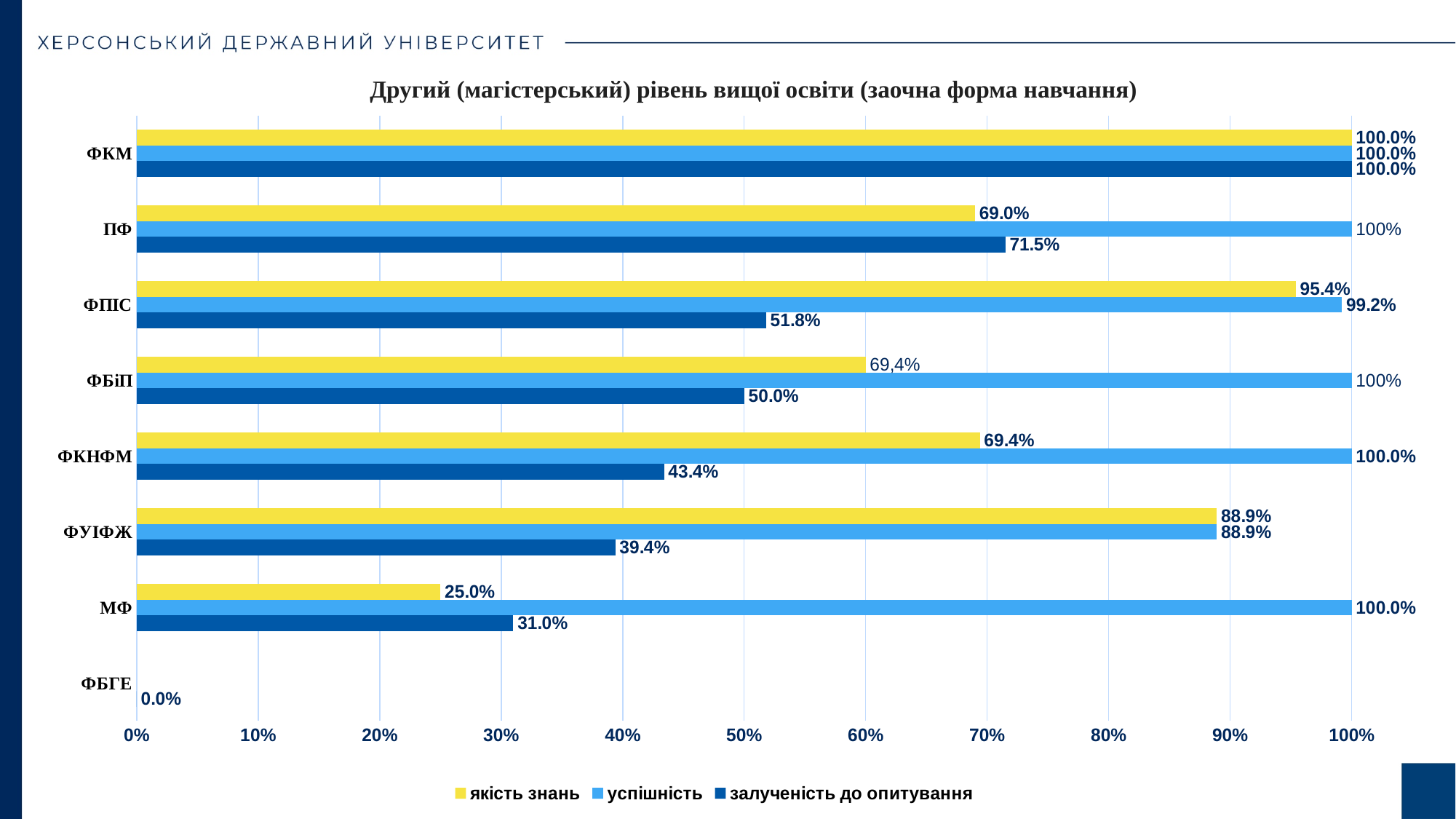
How many series does the legend list? 3 Which faculty has the lowest залученість до опитування among those with a non-zero value? МФ What is the value of залученість до опитування for ФПІС? 51.8% Which faculty has the highest залученість до опитування? ФКМ What is the value of успішність for ФУІФЖ? 88.9% Which is larger: залученість до опитування for ФБіП or for ФКНФМ? ФБіП What is the title of the chart? Другий (магістерський) рівень вищої освіти (заочна форма навчання) What is the difference between якість знань for ФПІС and for ФКНФМ? 26.0% What type of chart is shown on the slide? bar chart How many faculty categories are shown on the vertical axis? 8 What is the value of залученість до опитування for ПФ? 71.5% What is the value of якість знань for МФ? 25.0%